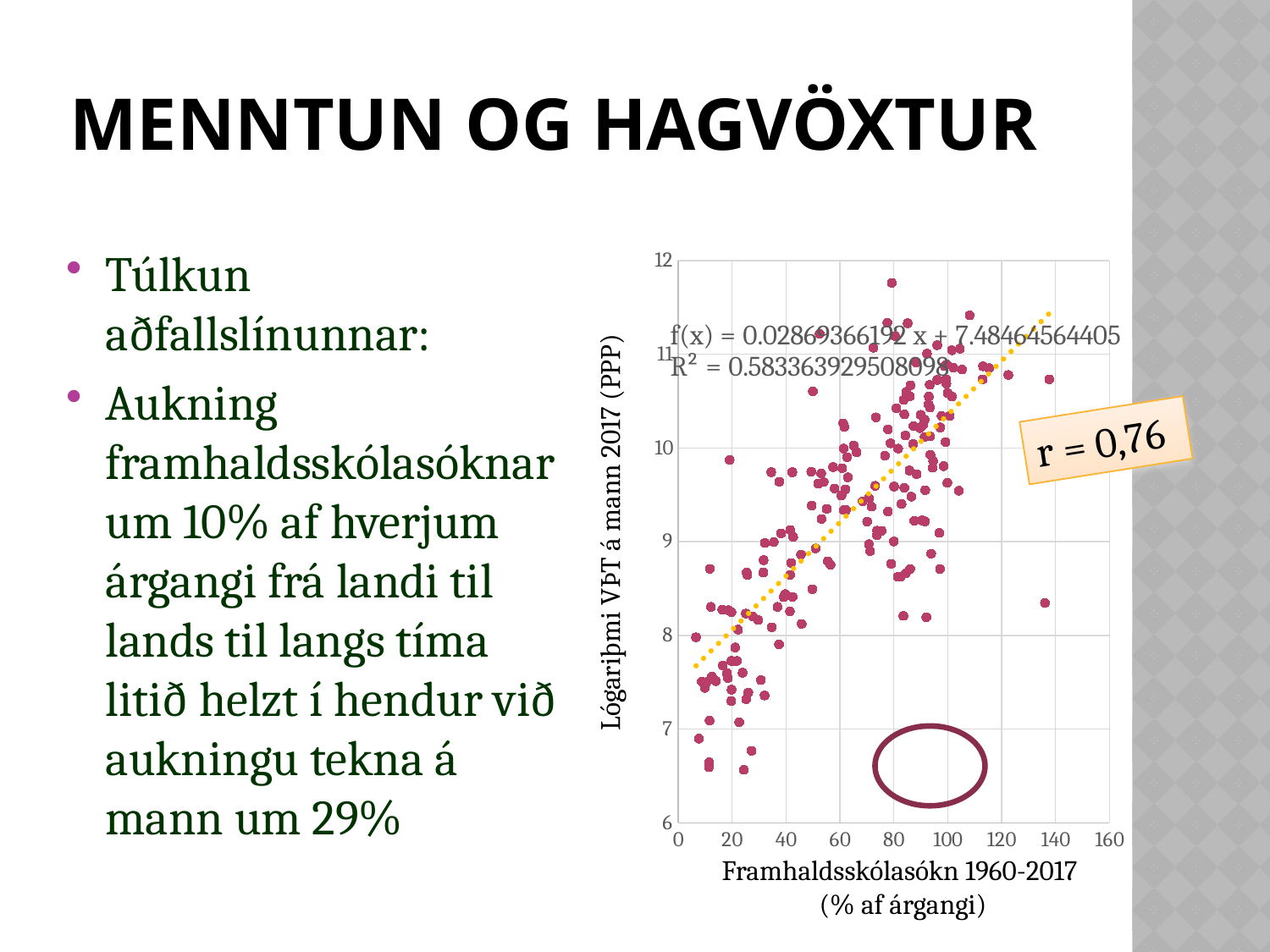
What R² value is printed on the chart? 0.583363929508098 Do the plotted values generally rise or fall as Framhaldsskólasókn increases along the x axis? rise What kind of chart is shown on the slide? scatter plot What correlation coefficient r is shown in the box next to the chart? r = 0,76